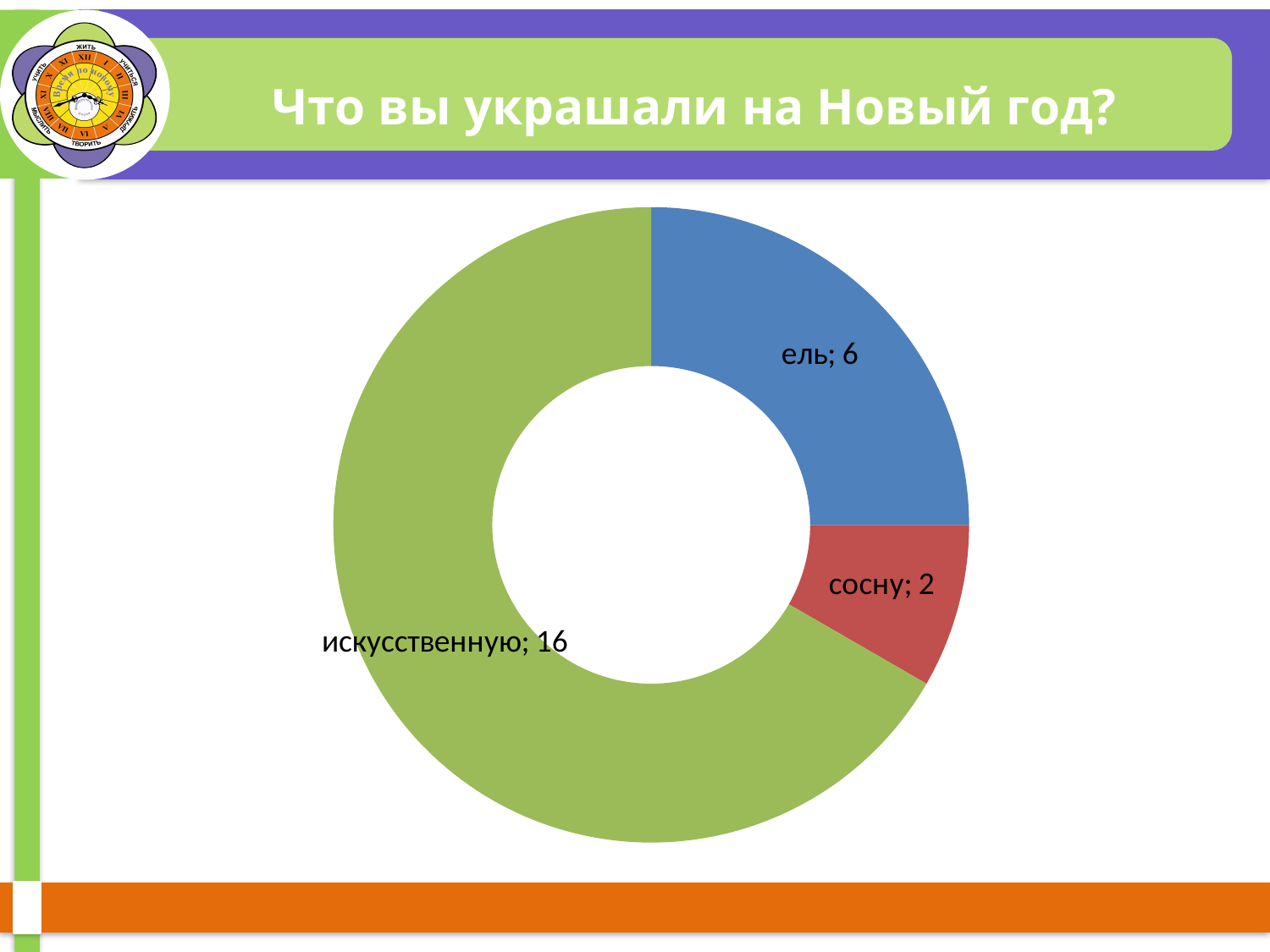
What is the value for ель? 6 What kind of chart is shown on the slide? doughnut chart What is the total of all values in the chart? 24 What is the difference between the values for ель and сосну? 4 Which category has the highest value? искусственную Which category has the lowest value? сосну Which is larger, the value for ель or the value for сосну? ель What is the value for сосну? 2 How many categories does the chart show? 3 What is the difference between the values for искусственную and ель? 10 What is the title of the slide above the chart? Что вы украшали на Новый год? What is the value for искусственную? 16